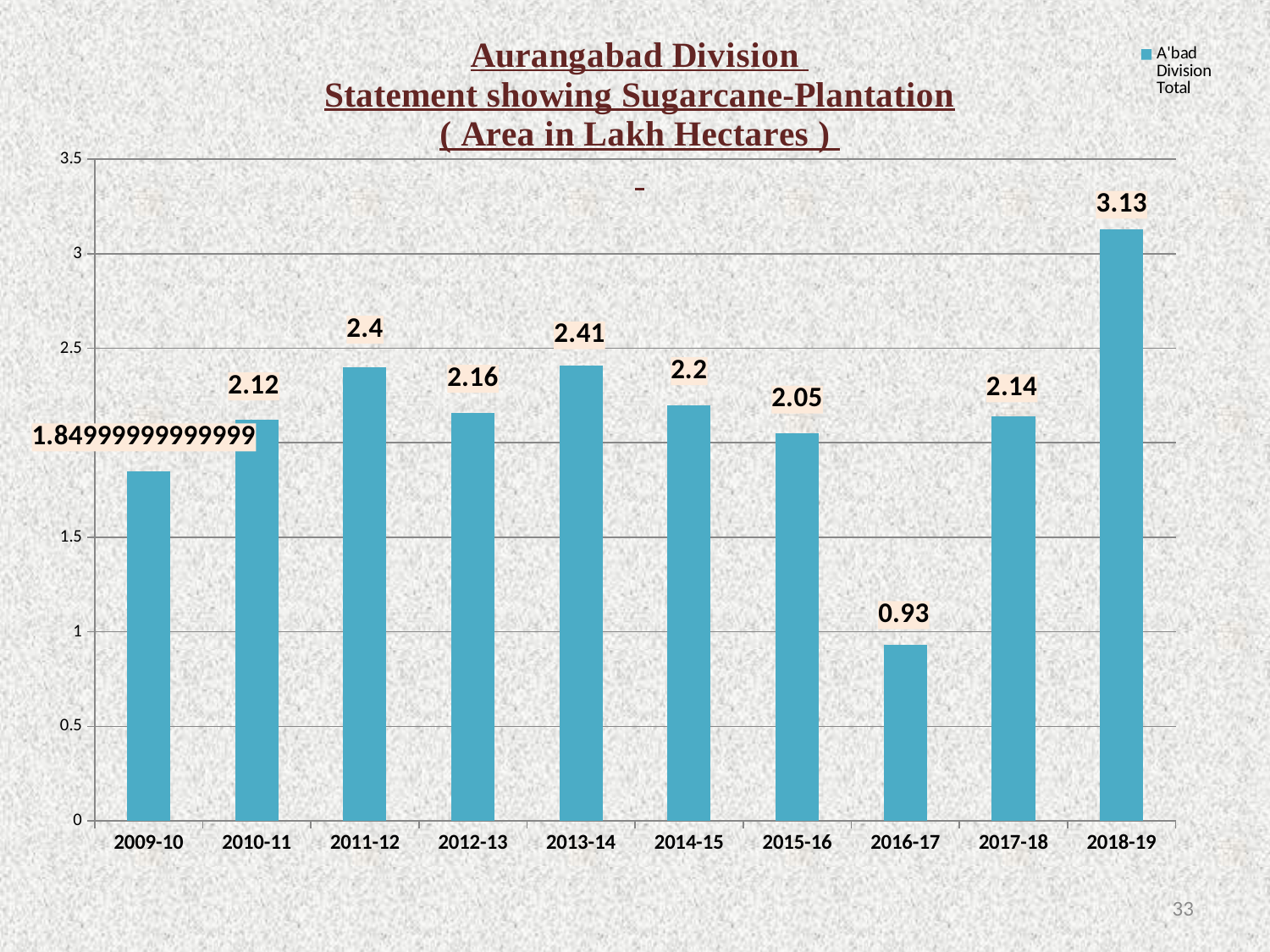
What is the value for 2013-14? 2.41 What kind of chart is shown on the slide? bar chart What is the difference between the values for 2018-19 and 2016-17? 2.2 Is the value for 2009-10 greater or less than 2? less Which year has the lowest value? 2016-17 What is the value for 2018-19? 3.13 Which year has the highest value? 2018-19 What is the difference between the values for 2011-12 and 2012-13? 0.24 Which is larger, the value for 2014-15 or the value for 2015-16? 2014-15 How many series does the legend list? 1 How many years are shown on the x axis? 10 What is the value for 2016-17? 0.93